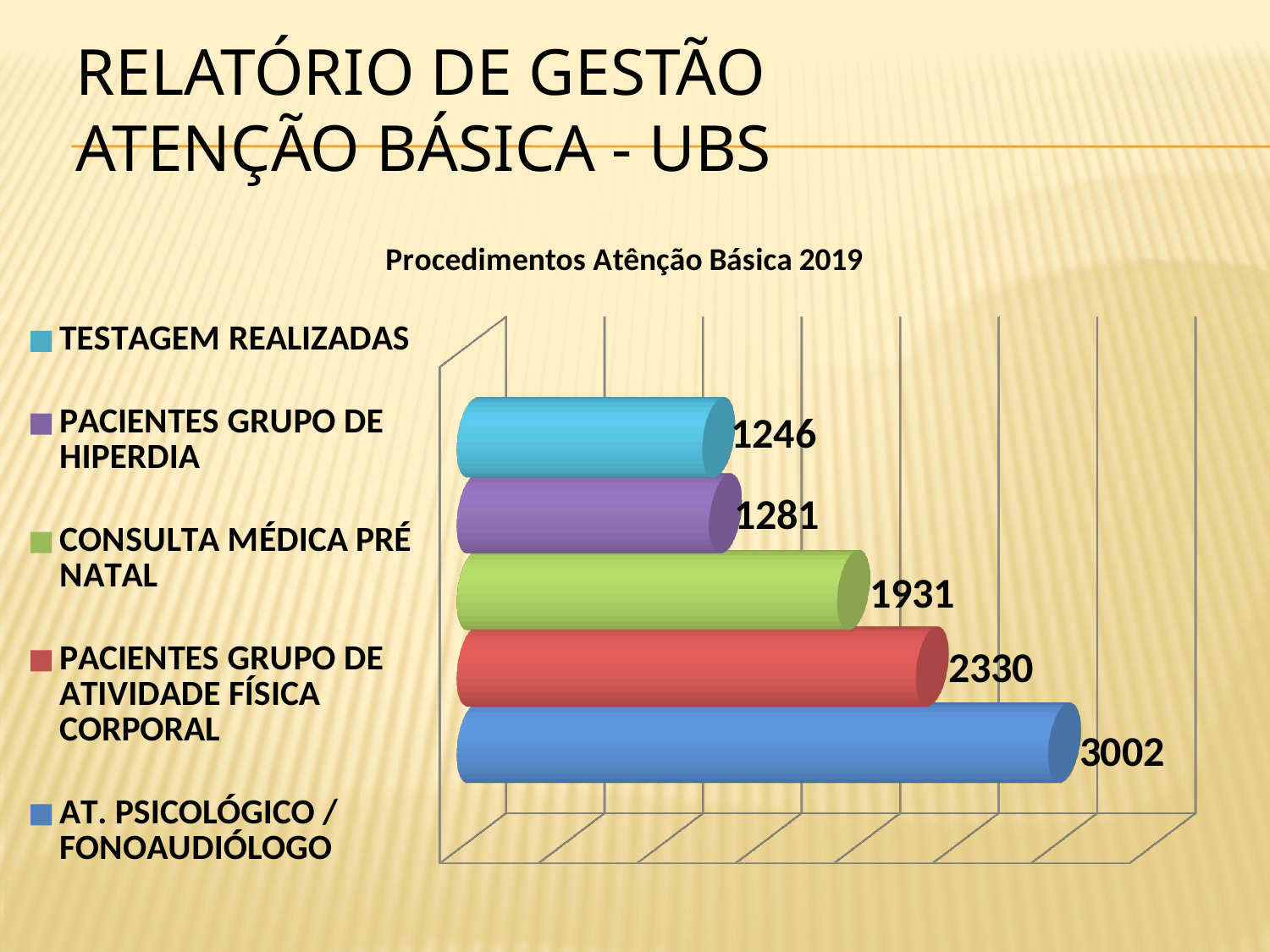
What kind of chart is shown? Bar chart How many entries does the legend list? 5 What is the difference between AT. PSICOLÓGICO / FONOAUDIÓLOGO and PACIENTES GRUPO DE ATIVIDADE FÍSICA CORPORAL? 672 Which category has the highest value? AT. PSICOLÓGICO / FONOAUDIÓLOGO What is the value for PACIENTES GRUPO DE ATIVIDADE FÍSICA CORPORAL? 2330 What is the value for TESTAGEM REALIZADAS? 1246 Which is larger, CONSULTA MÉDICA PRÉ NATAL or PACIENTES GRUPO DE HIPERDIA? CONSULTA MÉDICA PRÉ NATAL What is the value for AT. PSICOLÓGICO / FONOAUDIÓLOGO? 3002 What is the value for CONSULTA MÉDICA PRÉ NATAL? 1931 Which category has the lowest value? TESTAGEM REALIZADAS What is the value for PACIENTES GRUPO DE HIPERDIA? 1281 What is the title of the chart? Procedimentos Atênção Básica 2019